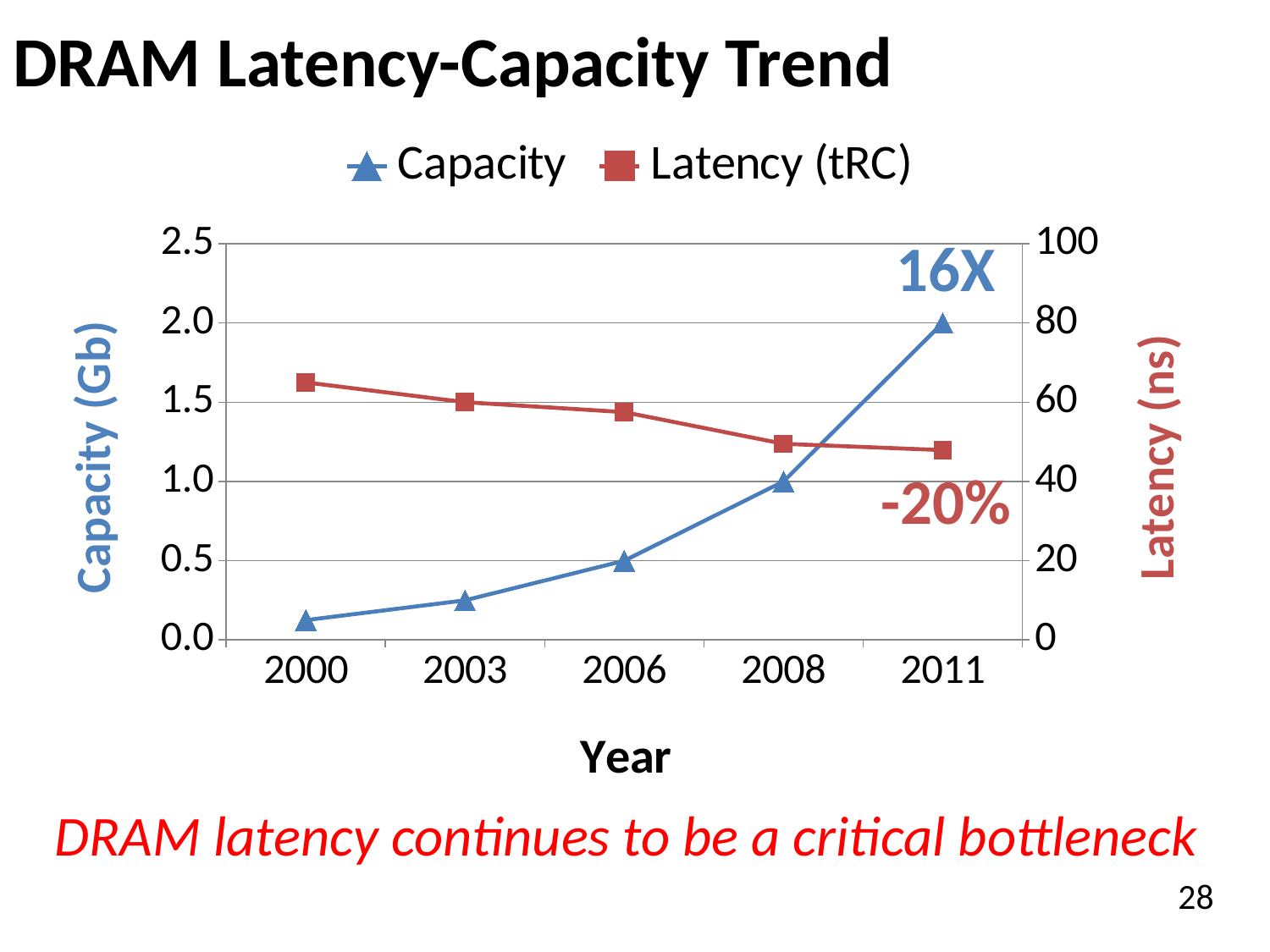
What kind of chart is shown on the slide? line chart Which year has the highest Latency (tRC)? 2000 Which year has the highest Capacity? 2011 Does Capacity rise or fall from 2000 to 2011? rise What is the Capacity value for 2011? 2.0 What annotation is printed next to the Capacity line at 2011? 16X Is the Latency (tRC) value for 2011 greater or less than 60? less How many years are plotted along the x axis? 5 What is the Capacity value for 2008? 1.0 Does Latency (tRC) rise or fall from 2000 to 2011? fall Is the Latency (tRC) value for 2000 greater or less than 60? greater How many series does the legend list? 2